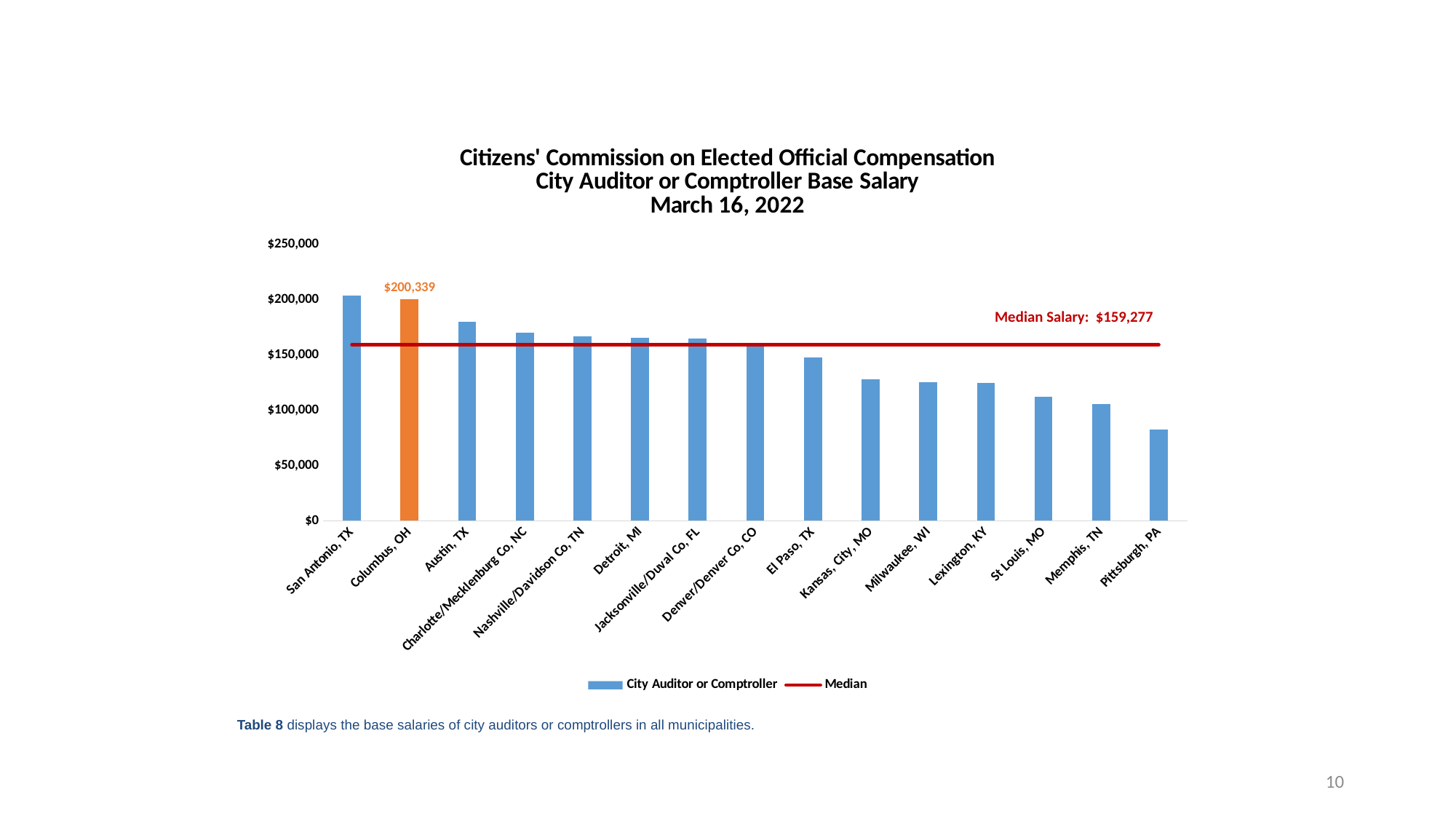
Is the value for Austin, TX greater or less than $150,000? greater What is the median salary shown on the chart? $159,277 Do the bar values rise or fall from left to right along the x axis? fall Is the value for Pittsburgh, PA greater or less than $100,000? less Which has the larger base salary, Detroit, MI or Memphis, TN? Detroit, MI Which municipality has the lowest City Auditor or Comptroller base salary? Pittsburgh, PA How many municipalities are shown on the chart? 15 Is the value for Kansas City, MO greater or less than $100,000? greater What is the base salary shown for Columbus, OH? $200,339 How many entries does the legend list? 2 Which has the larger base salary, Austin, TX or El Paso, TX? Austin, TX